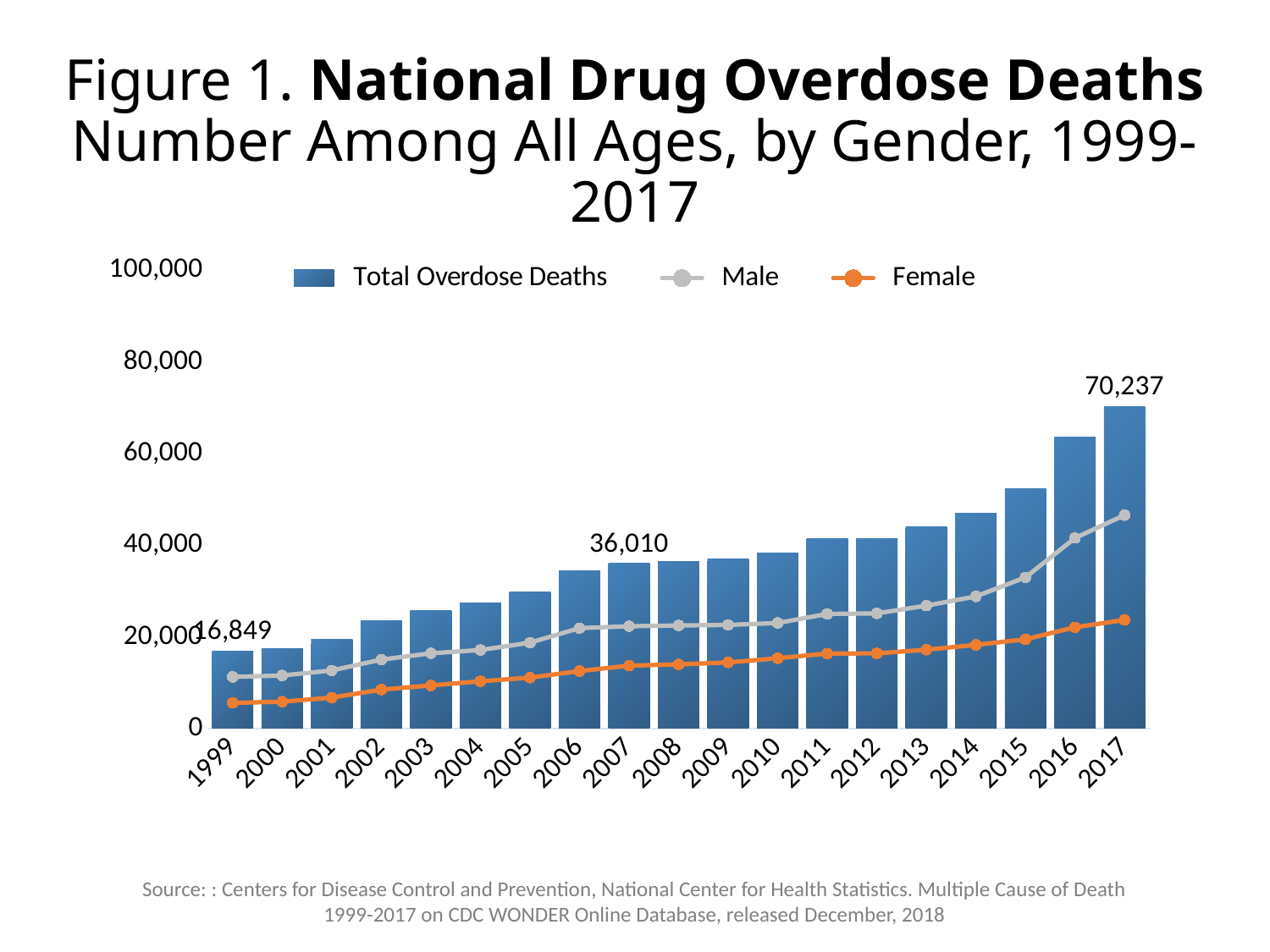
Is the Male value for 2017 greater or less than 40,000? greater How many series does the legend list? 3 Which year has the lowest Total Overdose Deaths? 1999 Is the Total Overdose Deaths value for 2016 greater or less than 60,000? greater Which year has the highest Total Overdose Deaths? 2017 What is the difference between Total Overdose Deaths in 2017 and in 1999? 53,388 What is the difference between Total Overdose Deaths in 2017 and in 2007? 34,227 What is the value of Total Overdose Deaths in 1999? 16,849 What is the value of Total Overdose Deaths in 2017? 70,237 Which is larger in 2017, the Male value or the Female value? Male How many years are shown on the x axis? 19 What is the value of Total Overdose Deaths in 2007? 36,010